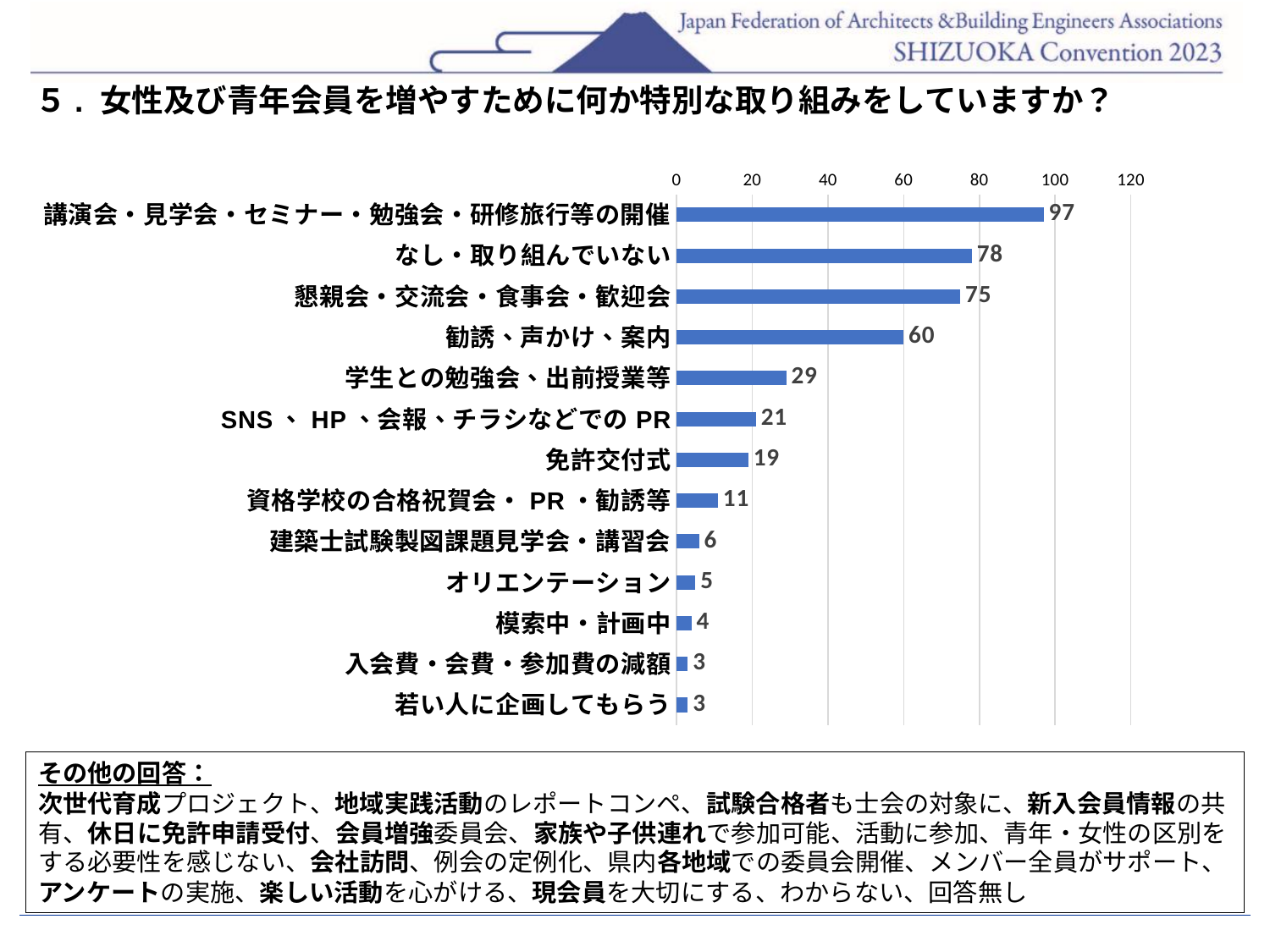
Which category has the highest value? 講演会・見学会・セミナー・勉強会・研修旅行等の開催 What is the maximum value shown on the chart's axis? 120 Is the value for なし・取り組んでいない greater or less than 80? less What is the value for 勧誘、声かけ、案内? 60 What kind of chart is shown on the slide? bar chart What is the value for 免許交付式? 19 What is the difference between なし・取り組んでいない and 懇親会・交流会・食事会・歓迎会? 3 What is the value for 講演会・見学会・セミナー・勉強会・研修旅行等の開催? 97 Which is larger, 資格学校の合格祝賀会・PR・勧誘等 or 建築士試験製図課題見学会・講習会? 資格学校の合格祝賀会・PR・勧誘等 What is the difference between 学生との勉強会、出前授業等 and SNS・HP・会報、チラシなどでのPR? 8 What is the lowest value shown in the chart? 3 How many categories are shown in the chart? 13